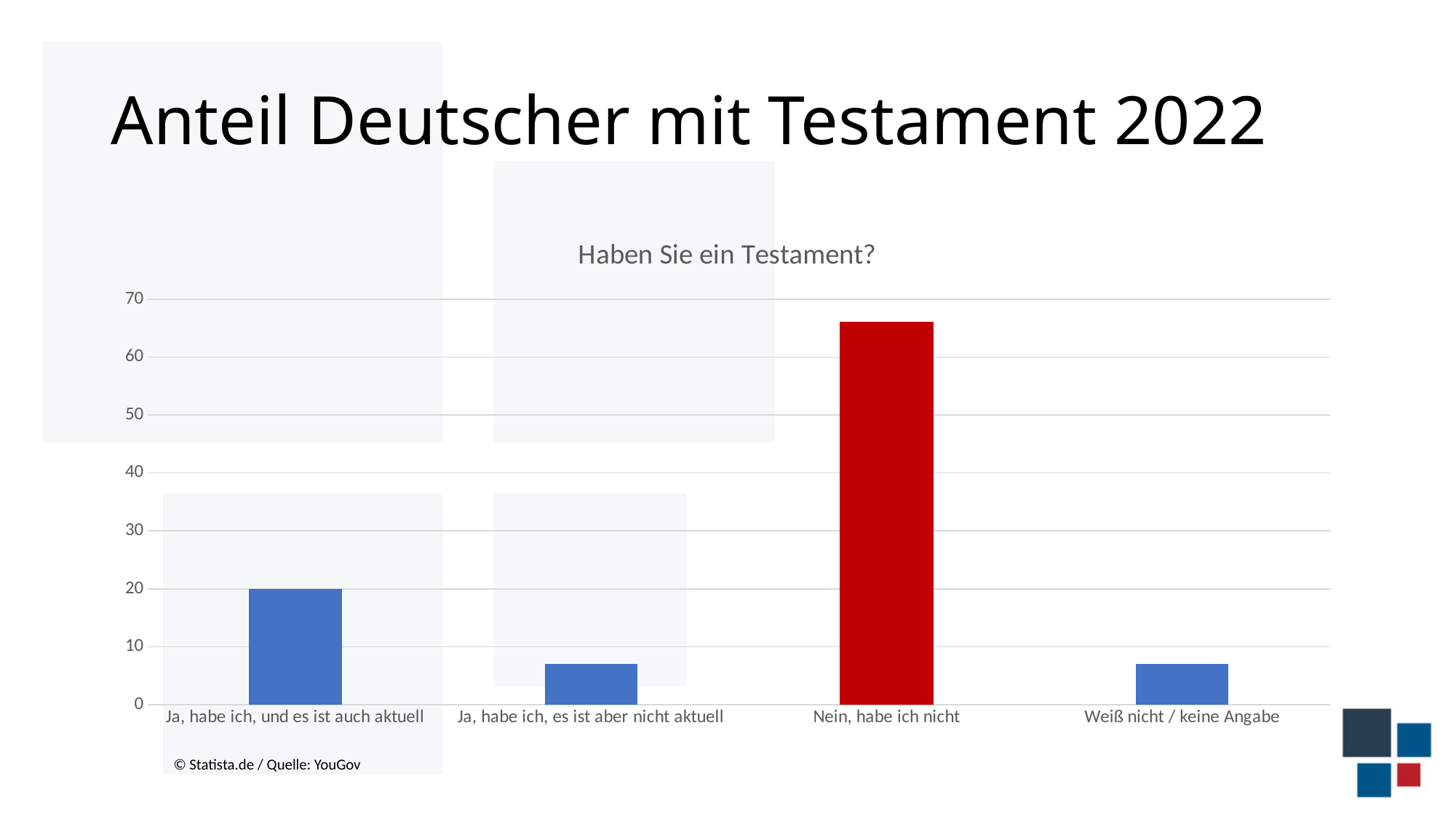
What is the title of the chart? Haben Sie ein Testament? Is the value for "Weiß nicht / keine Angabe" greater or less than 10? less Is the value for "Ja, habe ich, es ist aber nicht aktuell" greater or less than 10? less Which is larger: the value for "Ja, habe ich, und es ist auch aktuell" or the value for "Ja, habe ich, es ist aber nicht aktuell"? Ja, habe ich, und es ist auch aktuell Is the value for "Nein, habe ich nicht" greater or less than 70? less Which category has the highest value in the chart? Nein, habe ich nicht What kind of chart is shown on the slide? bar chart What is the value for "Ja, habe ich, und es ist auch aktuell"? 20 Which is larger: the value for "Nein, habe ich nicht" or the value for "Weiß nicht / keine Angabe"? Nein, habe ich nicht How many categories are shown on the x axis of the chart? 4 Which category's bar is coloured red in the chart? Nein, habe ich nicht